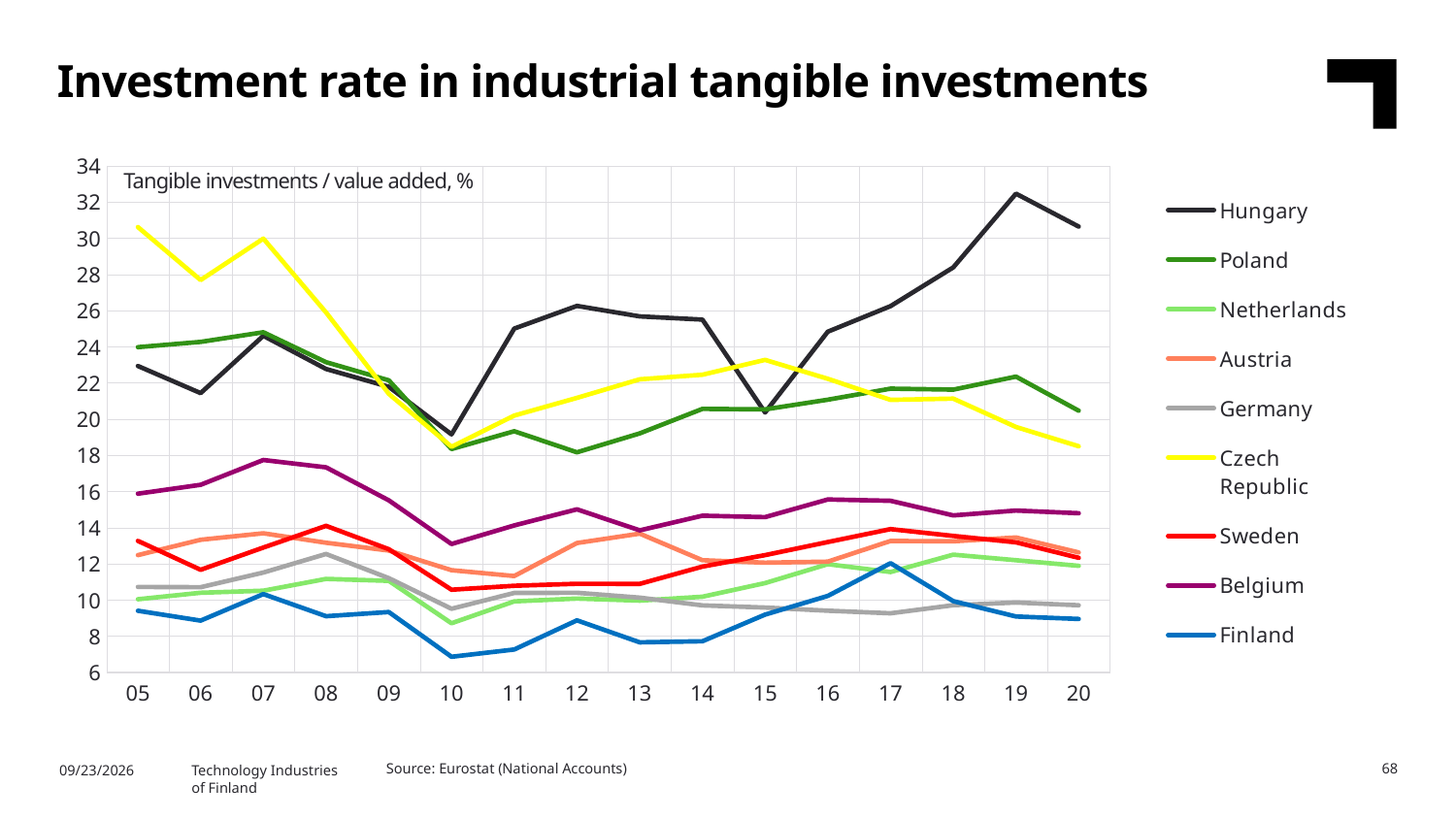
Is the value for Finland in 10 greater or less than 8? less Which country has the lowest investment rate in 20? Finland How many countries (series) does the legend list? 9 In 05, which has the higher investment rate, Czech Republic or Hungary? Czech Republic Is the value for Hungary in 19 greater or less than 30? greater Which country has the highest investment rate in 20? Hungary How many years are shown along the x axis? 16 What type of chart is shown on the slide? line chart What is the source cited for the chart data? Eurostat (National Accounts) Is the value for Poland in 12 greater or less than 20? less In 08, which has the higher investment rate, Belgium or Sweden? Belgium Does the Czech Republic line rise or fall from 15 to 20? fall